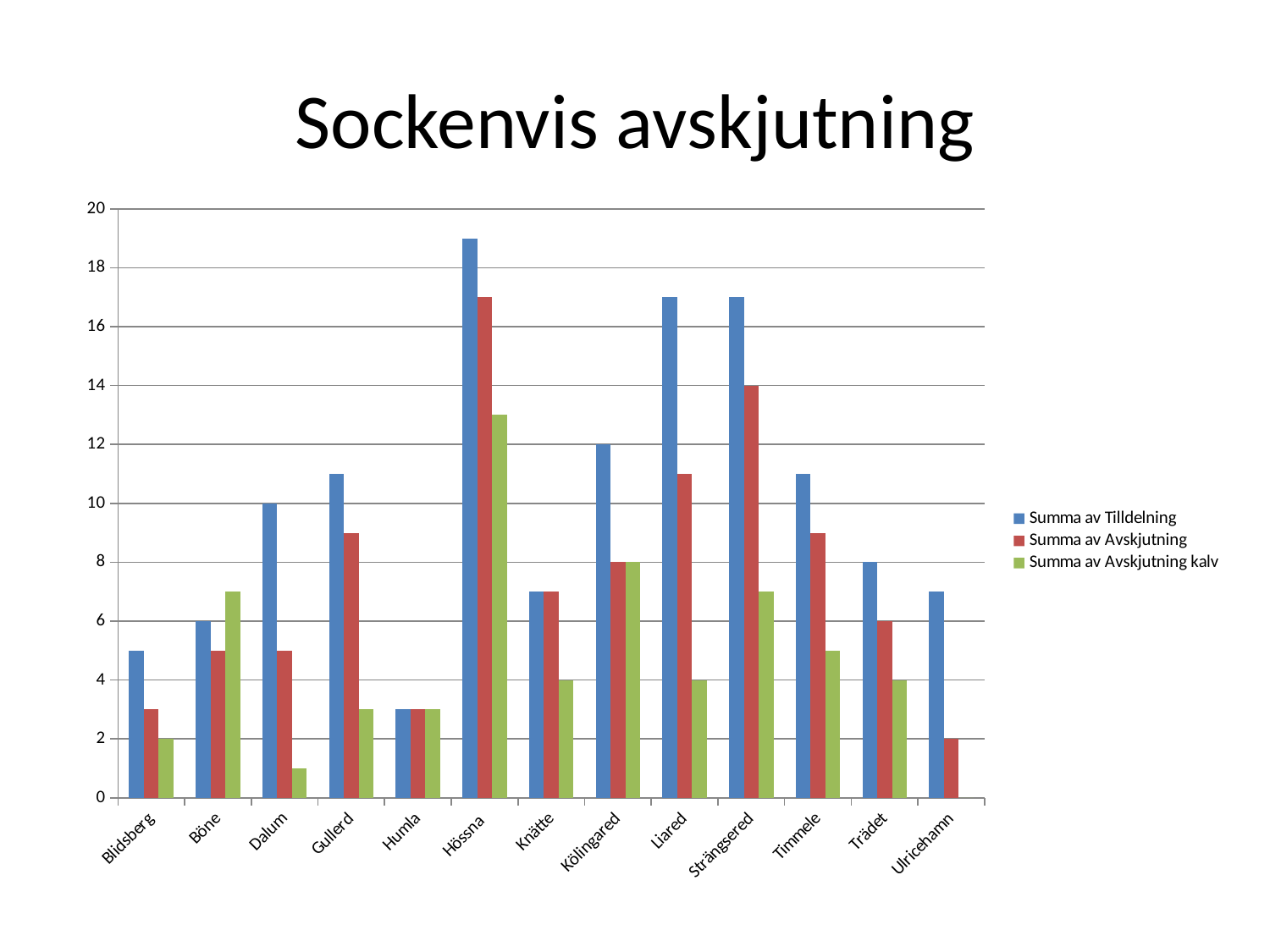
How many series does the legend list? 3 Which is larger: Summa av Tilldelning for Hössna or for Liared? Hössna What is the value of Summa av Tilldelning for Kölingared? 12 What type of chart is shown on the slide? bar chart Which category has the lowest Summa av Tilldelning? Humla What is the value of Summa av Tilldelning for Dalum? 10 What is the title of the chart? Sockenvis avskjutning Which category has the highest Summa av Tilldelning? Hössna What is the difference between Summa av Tilldelning and Summa av Avskjutning for Kölingared? 4 Is the value of Summa av Tilldelning for Hössna greater or less than 18? greater How many categories are shown on the x axis? 13 What is the value of Summa av Avskjutning for Strängsered? 14